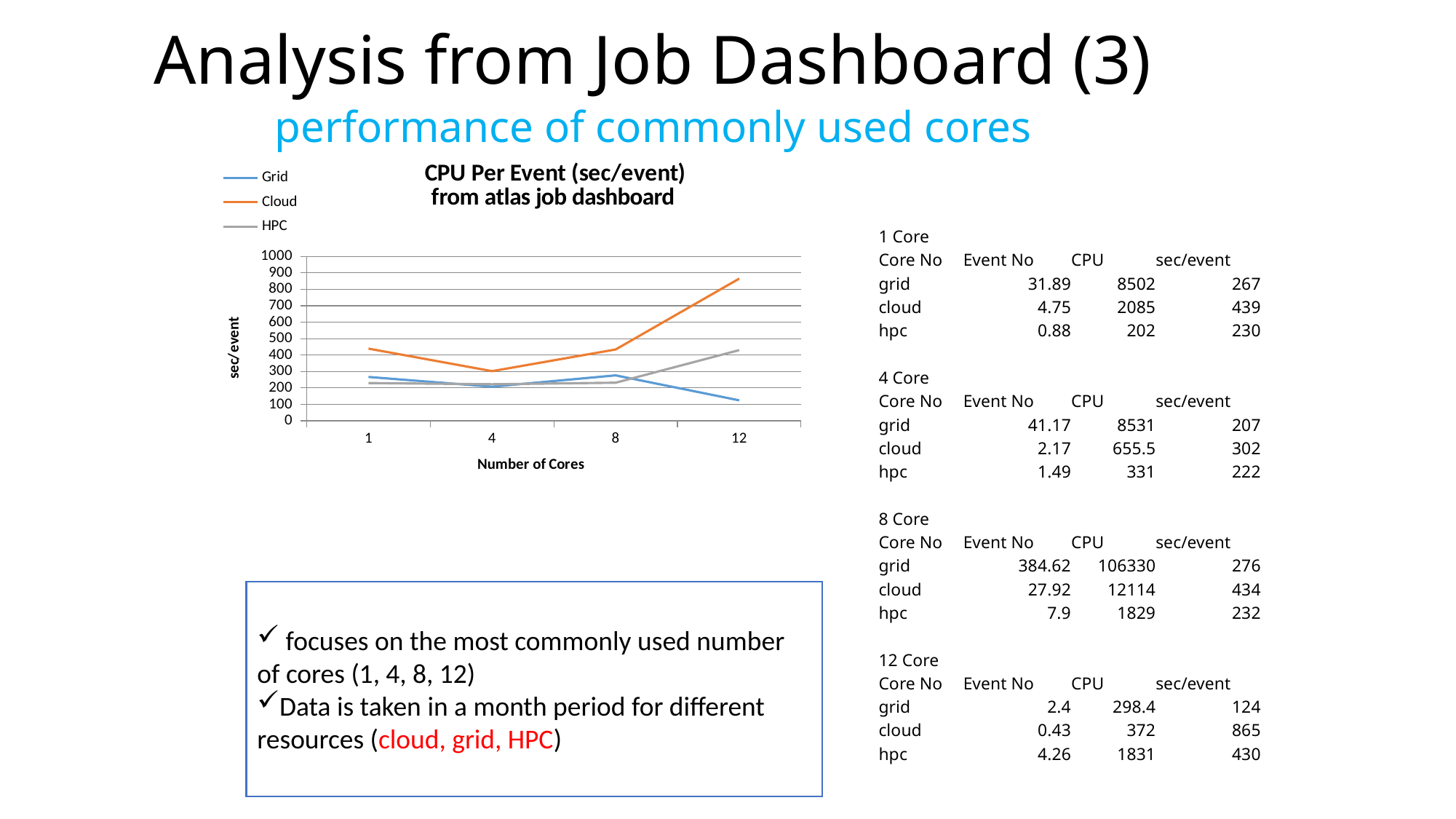
Is the Cloud value at 12 cores greater or less than 800? greater How many series does the chart legend list? 3 How many core counts are plotted along the x axis of the chart? 4 At 8 cores, which is larger, the Cloud value or the Grid value? Cloud Which series has the highest sec/event value at 1 core? Cloud Is the Grid value at 12 cores greater or less than 200? less Which series has the highest sec/event value at 12 cores? Cloud Is the Cloud value at 4 cores greater or less than 400? less Which series has the lowest sec/event value at 12 cores? Grid Does the Cloud line rise or fall between 4 cores and 12 cores? rise What is the label on the x axis of the chart? Number of Cores What kind of chart is shown on the slide? line chart